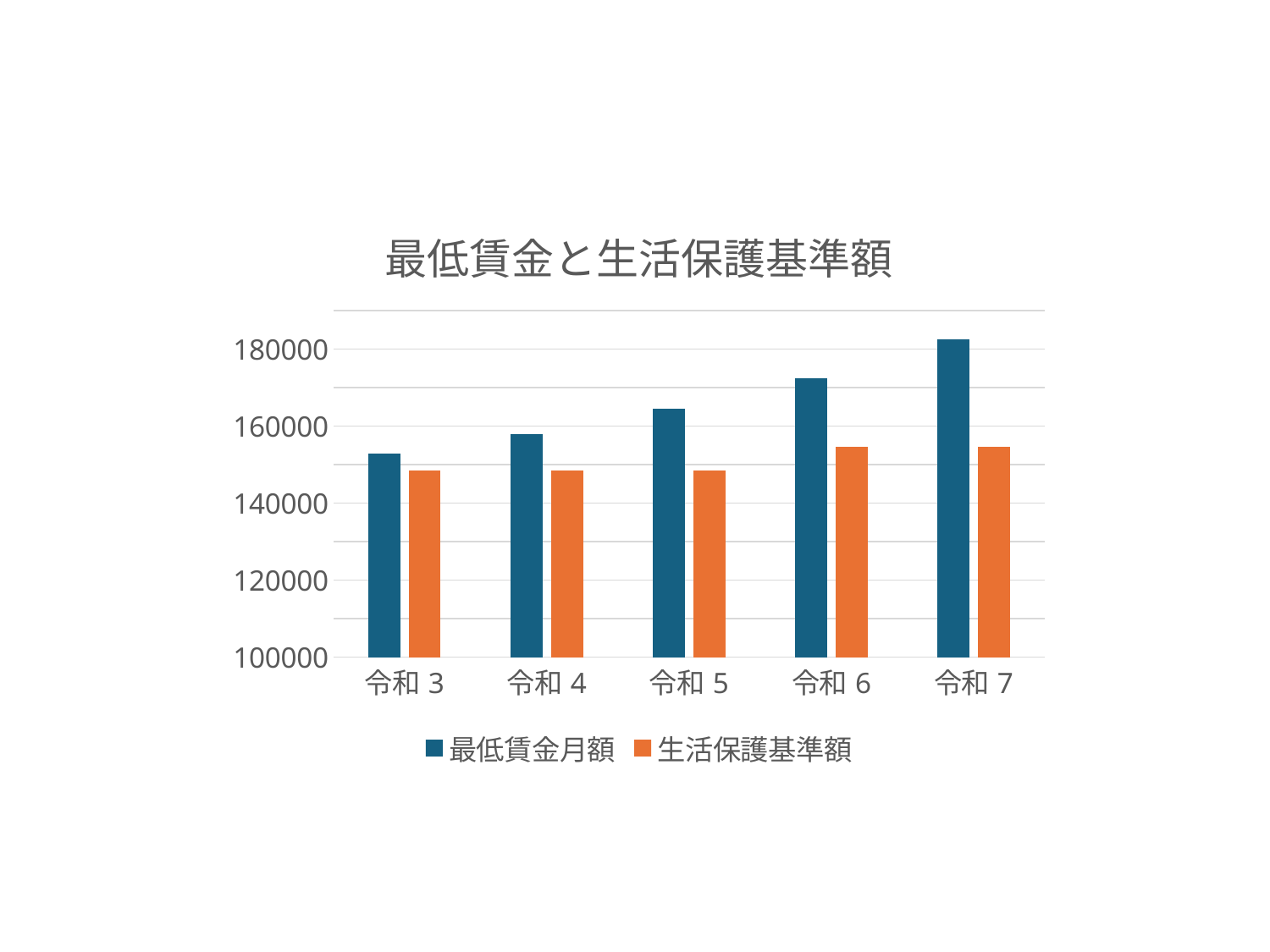
How many series does the legend list? 2 How many categories are shown on the x axis? 5 Is the value for 最低賃金月額 in 令和 7 greater or less than 180000? greater Is the value for 最低賃金月額 in 令和 3 greater or less than 160000? less What kind of chart is shown on the slide? bar chart What is the title of the chart? 最低賃金と生活保護基準額 Do the values for 最低賃金月額 rise or fall from 令和 3 to 令和 7? rise Which category has the lowest value for 最低賃金月額? 令和 3 In 令和 7, which is larger: 最低賃金月額 or 生活保護基準額? 最低賃金月額 Is the value for 生活保護基準額 in 令和 7 greater or less than 160000? less Which category has the highest value for 最低賃金月額? 令和 7